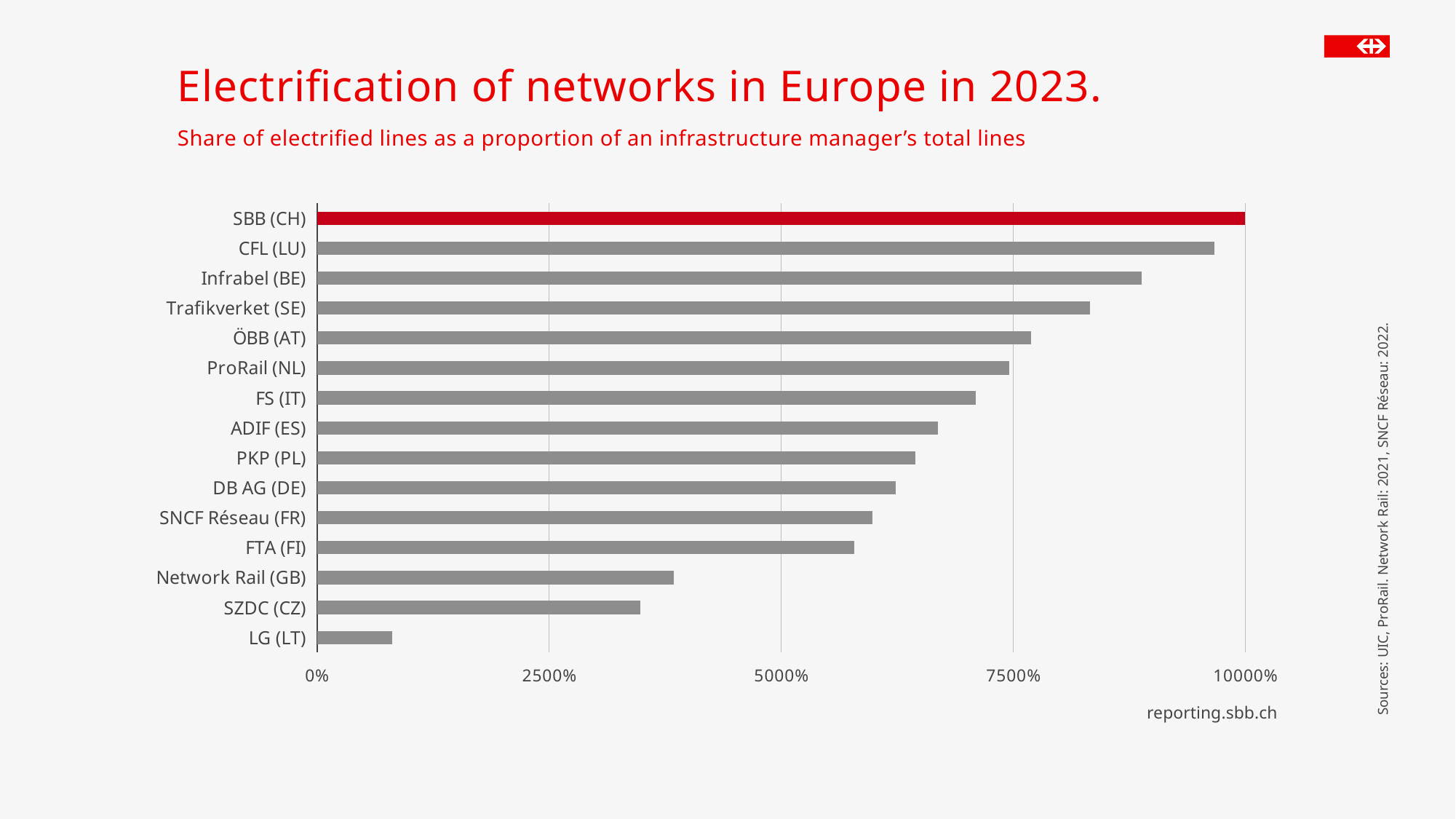
Which infrastructure manager's bar is highlighted in red? SBB (CH) Which infrastructure manager has the lowest share of electrified lines? LG (LT) Is the value for LG (LT) greater or less than 2500%? less Is the value for FTA (FI) greater or less than 5000%? greater What kind of chart is shown on the slide? bar chart Which infrastructure manager has the highest share of electrified lines? SBB (CH) Is the value for CFL (LU) greater or less than 7500%? greater Which has the larger share of electrified lines, CFL (LU) or Infrabel (BE)? CFL (LU) Which has the larger share of electrified lines, Network Rail (GB) or SZDC (CZ)? Network Rail (GB) How many infrastructure managers are listed in the chart? 15